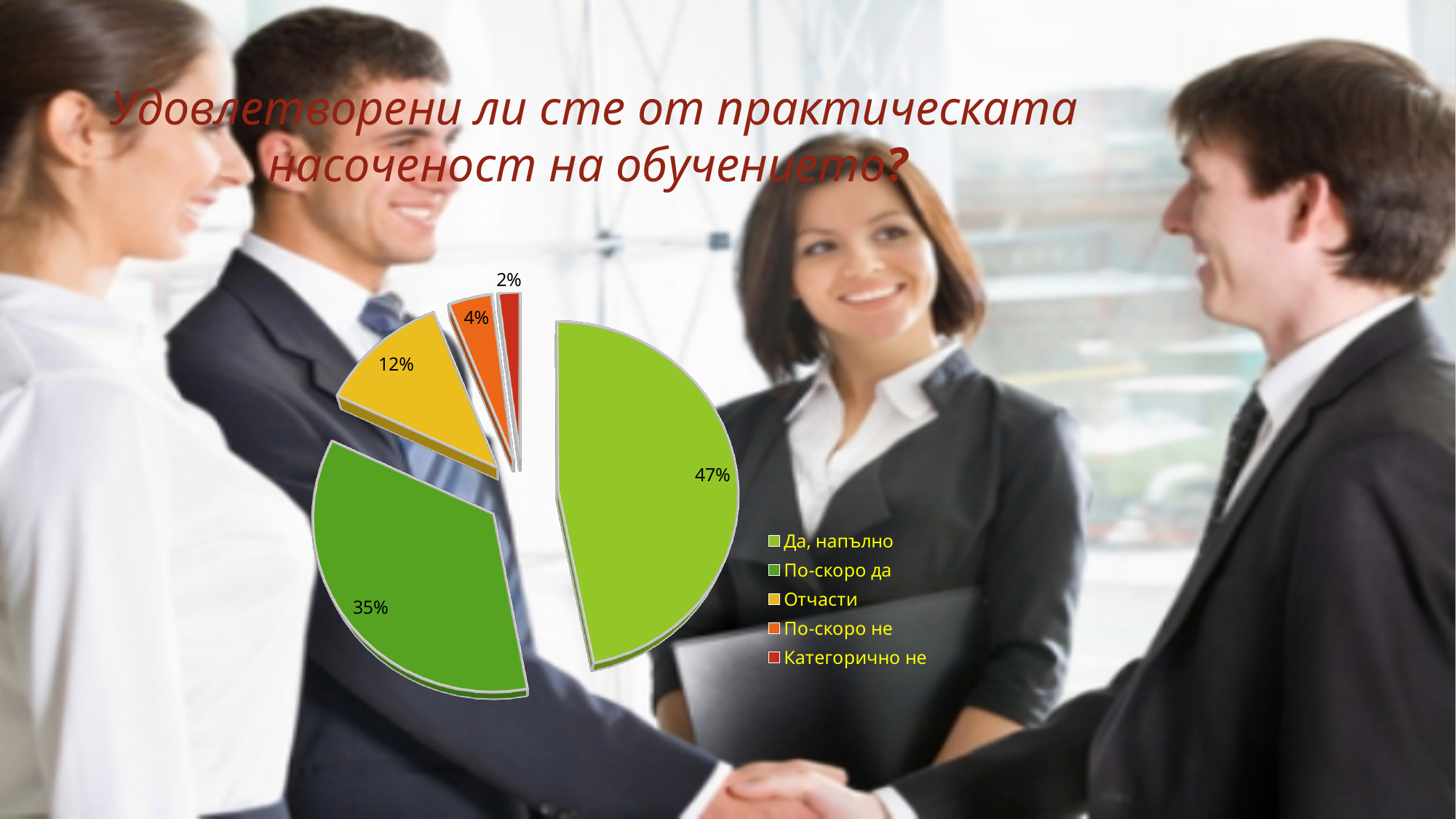
What percentage of respondents answered "Категорично не"? 2% Which answer category has the largest share of the pie? Да, напълно What percentage of respondents answered "По-скоро не"? 4% What kind of chart is shown on the slide? pie chart What percentage of respondents answered "Да, напълно"? 47% What is the difference in percentage points between "Да, напълно" and "По-скоро да"? 12 What percentage of respondents answered "По-скоро да"? 35% What question is shown as the title above the chart? Удовлетворени ли сте от практическата насоченост на обучението? Which is larger, the share for "Отчасти" or the share for "По-скоро не"? Отчасти Which answer category has the smallest share of the pie? Категорично не What percentage of respondents answered "Отчасти"? 12% How many categories does the legend of the pie chart list? 5